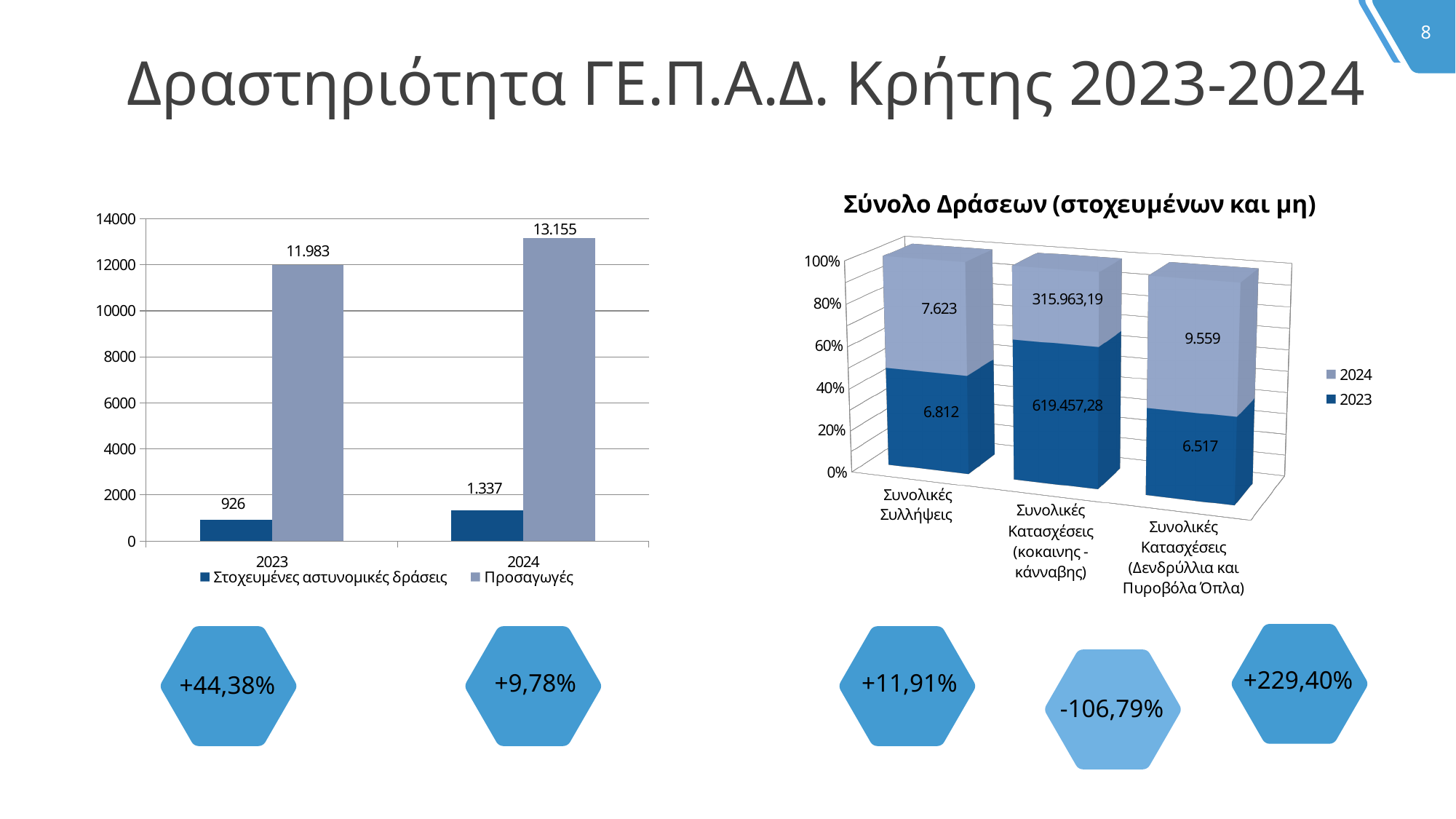
In the left chart, what is the value of Στοχευμένες αστυνομικές δράσεις for 2024? 1.337 In the chart titled 'Σύνολο Δράσεων (στοχευμένων και μη)', which is larger for Συνολικές Κατασχέσεις (κοκαινης - κάνναβης): the 2023 value or the 2024 value? 2023 In the chart titled 'Σύνολο Δράσεων (στοχευμένων και μη)', what is the difference between the 2024 and 2023 values for Συνολικές Κατασχέσεις (Δενδρύλλια και Πυροβόλα Όπλα)? 3.042 In the chart titled 'Σύνολο Δράσεων (στοχευμένων και μη)', what is the 2024 value for Συνολικές Κατασχέσεις (κοκαινης - κάνναβης)? 315.963,19 In the left chart, what is the difference between Προσαγωγές in 2024 and in 2023? 1.172 What is the title of the right chart? Σύνολο Δράσεων (στοχευμένων και μη) In the left chart, what is the value of Προσαγωγές for 2023? 11.983 What kind of chart is the left chart? bar chart In the left chart, is the value of Στοχευμένες αστυνομικές δράσεις for 2023 greater or less than 2000? less In the chart titled 'Σύνολο Δράσεων (στοχευμένων και μη)', what is the 2023 value for Συνολικές Συλλήψεις? 6.812 In the left chart, how many series does the legend list? 2 How many categories are shown on the x axis of the chart titled 'Σύνολο Δράσεων (στοχευμένων και μη)'? 3